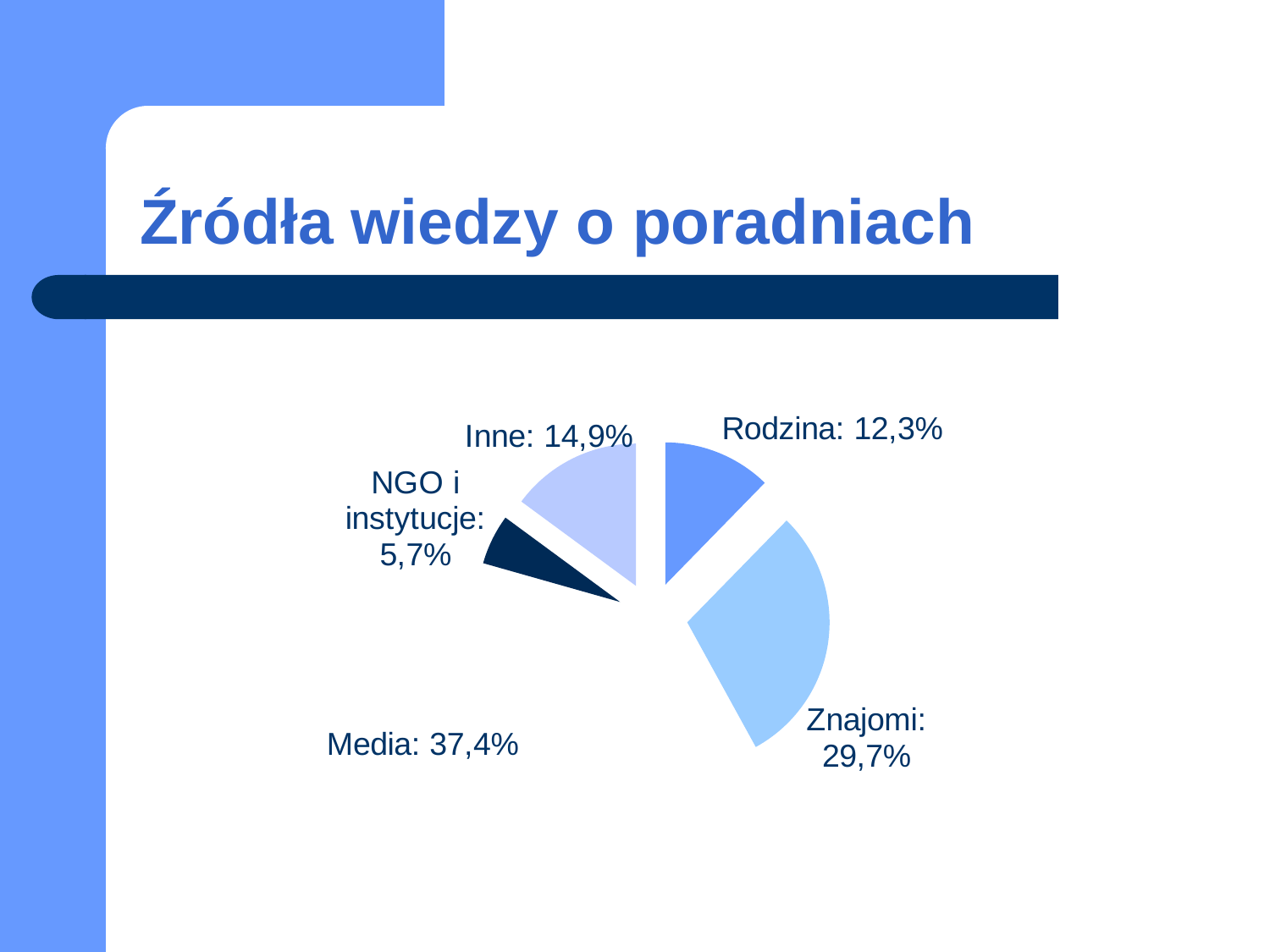
What is the value for Znajomi? 29,7% Which category has the largest share? Media What type of chart is shown on the slide? pie chart What is the value for Inne? 14,9% Which is larger, Znajomi or Inne? Znajomi What is the value for NGO i instytucje? 5,7% What is the difference between the values for Media and Znajomi? 7,7 percentage points What is the value for Rodzina? 12,3% What is the title of the chart on the slide? Źródła wiedzy o poradniach How many categories are shown in the pie chart? 5 Which category has the smallest share? NGO i instytucje What is the value for Media? 37,4%